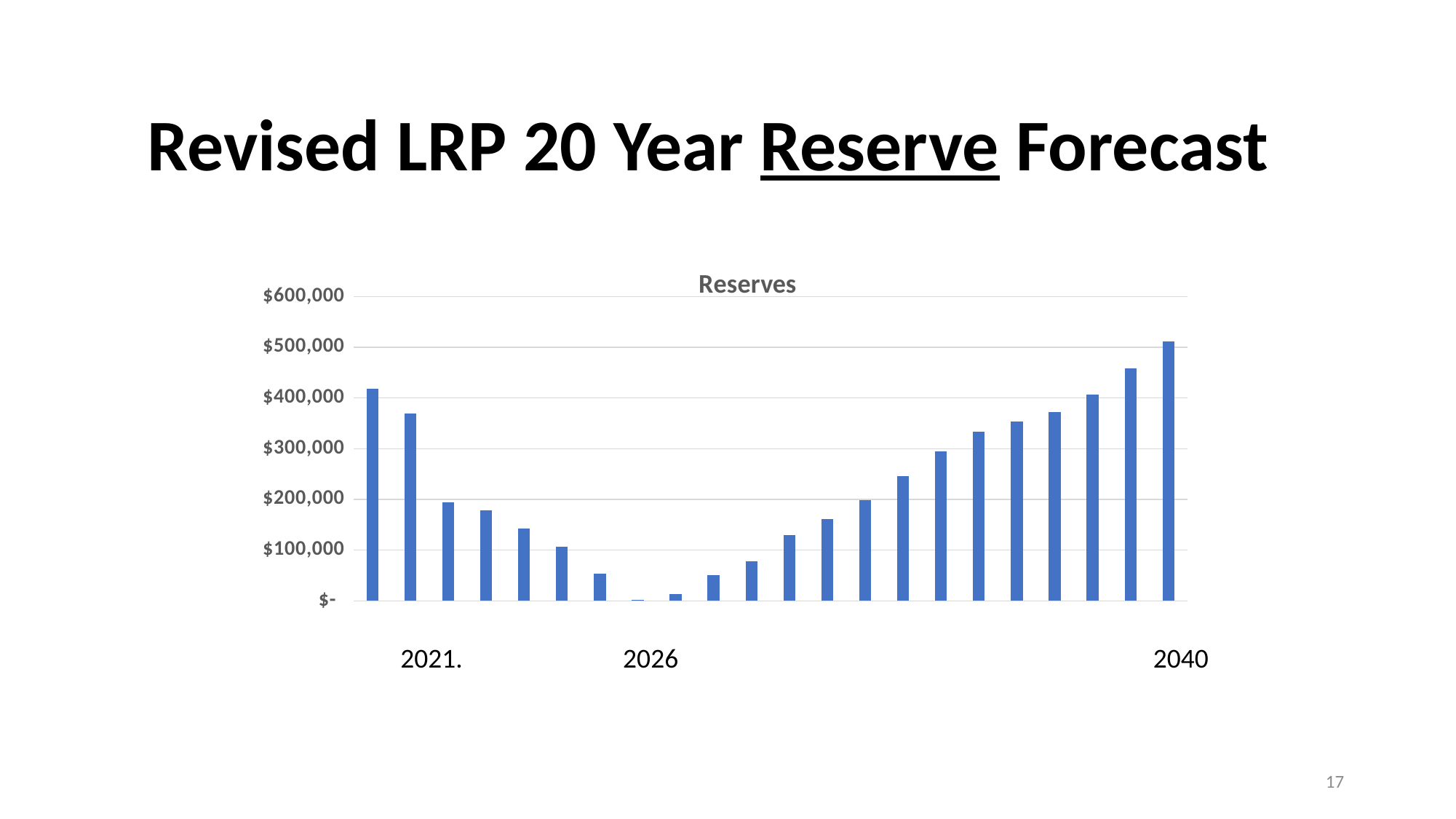
What is the title of the chart? Reserves Which is larger in the Reserves chart, the leftmost bar or the rightmost bar? the rightmost bar Is the value of the lowest bar in the Reserves chart greater or less than $100,000? less Is the value of the first (leftmost) bar in the Reserves chart greater or less than $400,000? greater What kind of chart is shown on the slide? bar chart Which bar in the Reserves chart is the highest: the leftmost bar, the rightmost bar, or a bar in the middle? the rightmost bar Do the values in the Reserves chart rise or fall from the leftmost bar toward the middle of the chart? fall What is the highest value shown on the vertical axis of the Reserves chart? $600,000 Do the values in the Reserves chart rise or fall from the middle of the chart toward the rightmost bar? rise Is the value of the last (rightmost) bar in the Reserves chart greater or less than $400,000? greater Where is the lowest bar in the Reserves chart: at the left end, at the right end, or in the middle? in the middle